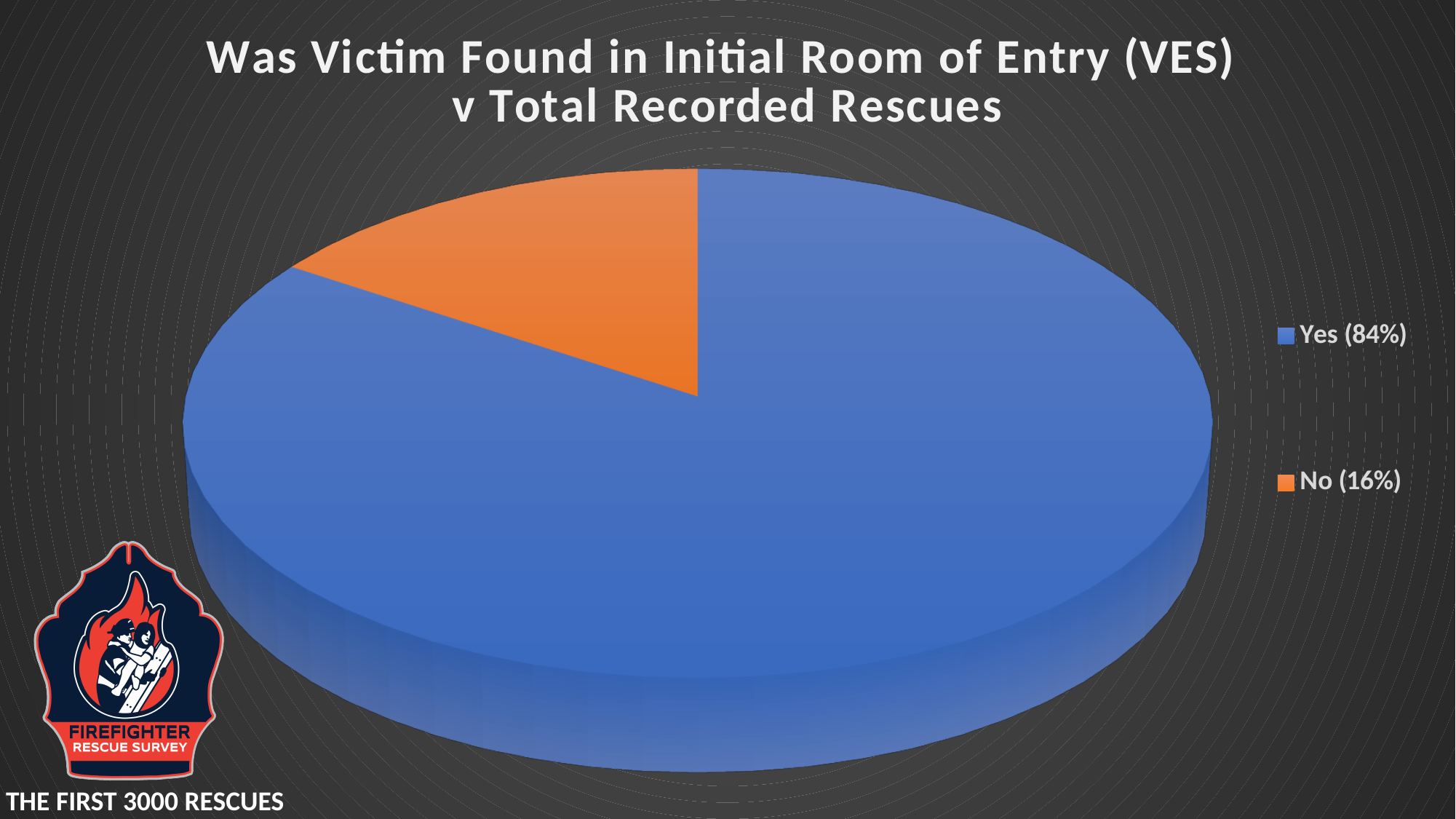
What share of the pie does the "Yes" slice represent? 84% How many entries does the legend list? 2 Which slice is larger, "Yes" or "No"? Yes What share of the pie does the "No" slice represent? 16% What kind of chart is shown on the slide? pie chart What is the difference in percentage points between the "Yes" and "No" slices? 68 What colour is the "No" slice of the pie? orange Which category has the smallest slice of the pie? No What is the title of the chart? Was Victim Found in Initial Room of Entry (VES) v Total Recorded Rescues Which category has the largest slice of the pie? Yes How many slices does the pie chart have? 2